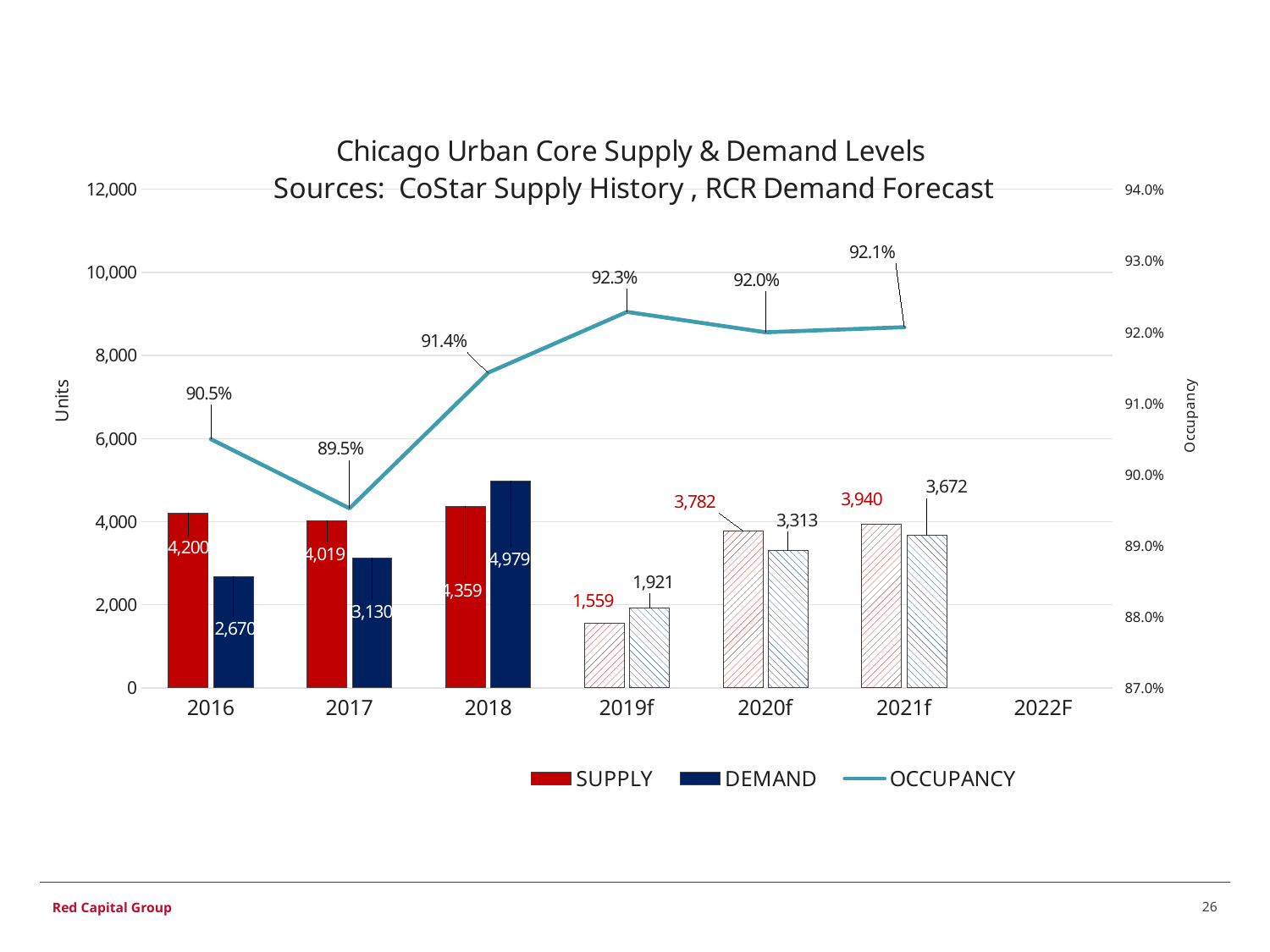
Which year has the lowest SUPPLY value? 2019f What kind of chart is this? Combined bar and line chart Which year has the lowest OCCUPANCY value? 2017 What is the DEMAND value for 2020f? 3,313 What is the SUPPLY value for 2018? 4,359 What is the difference between SUPPLY and DEMAND in 2016? 1,530 Does OCCUPANCY rise or fall from 2017 to 2019f? Rise What colour represents SUPPLY in the legend? Red What is the OCCUPANCY value for 2017? 89.5% Which year has the highest DEMAND value? 2018 Which is larger in 2021f, SUPPLY or DEMAND? SUPPLY How many series does the legend list? 3